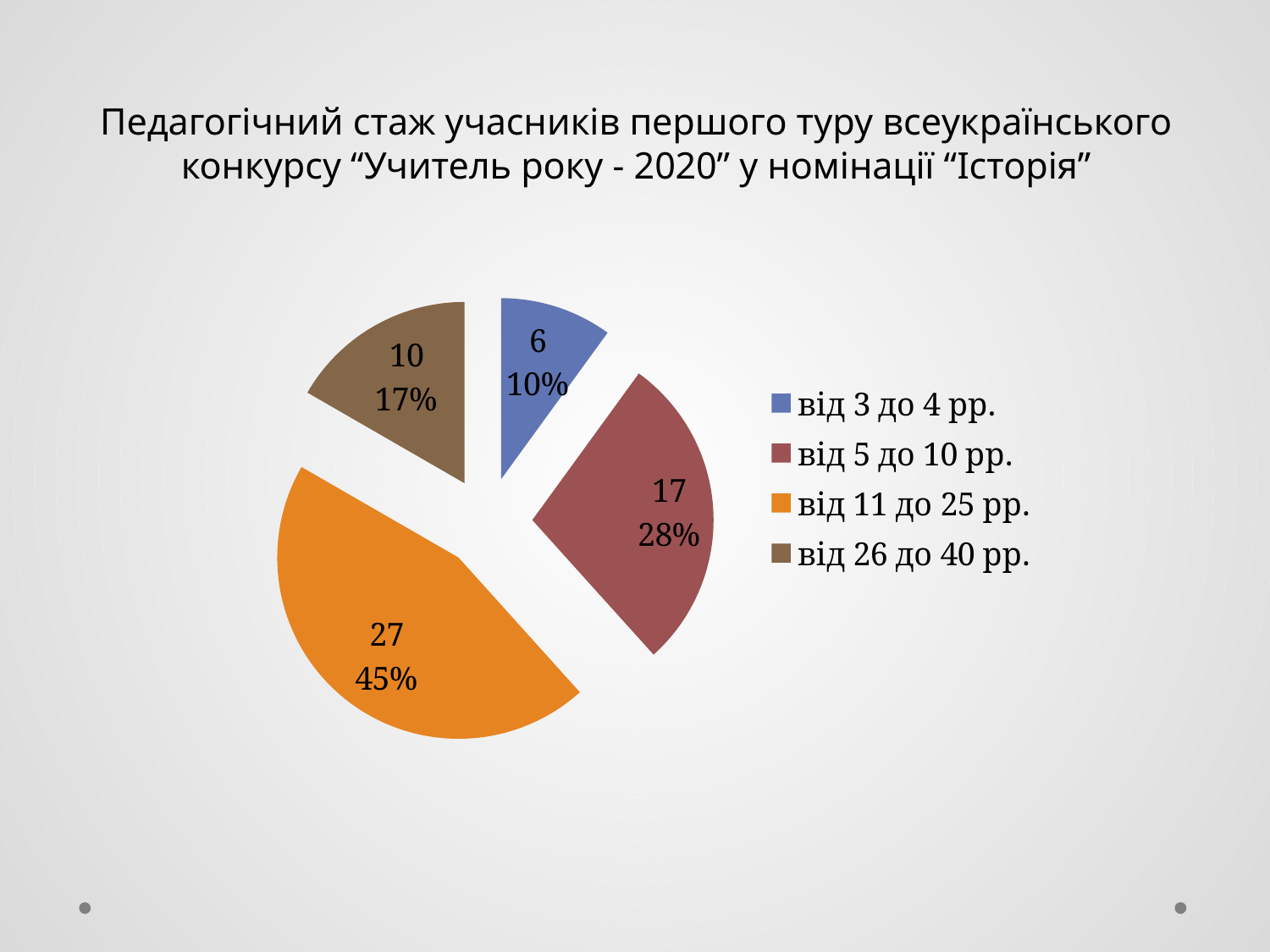
How many slices does the pie chart have? 4 What is the value for the category "від 5 до 10 рр."? 17 What is the difference between the values for "від 11 до 25 рр." and "від 5 до 10 рр."? 10 Which category has the largest slice? від 11 до 25 рр. Which category has the smallest slice? від 3 до 4 рр. What is the value for the category "від 3 до 4 рр."? 6 What is the value for the category "від 26 до 40 рр."? 10 How many entries does the legend list? 4 What kind of chart is shown on the slide? pie chart What share of the pie does the slice "від 11 до 25 рр." represent? 45% What is the value for the category "від 11 до 25 рр."? 27 What share of the pie does the slice "від 26 до 40 рр." represent? 17%